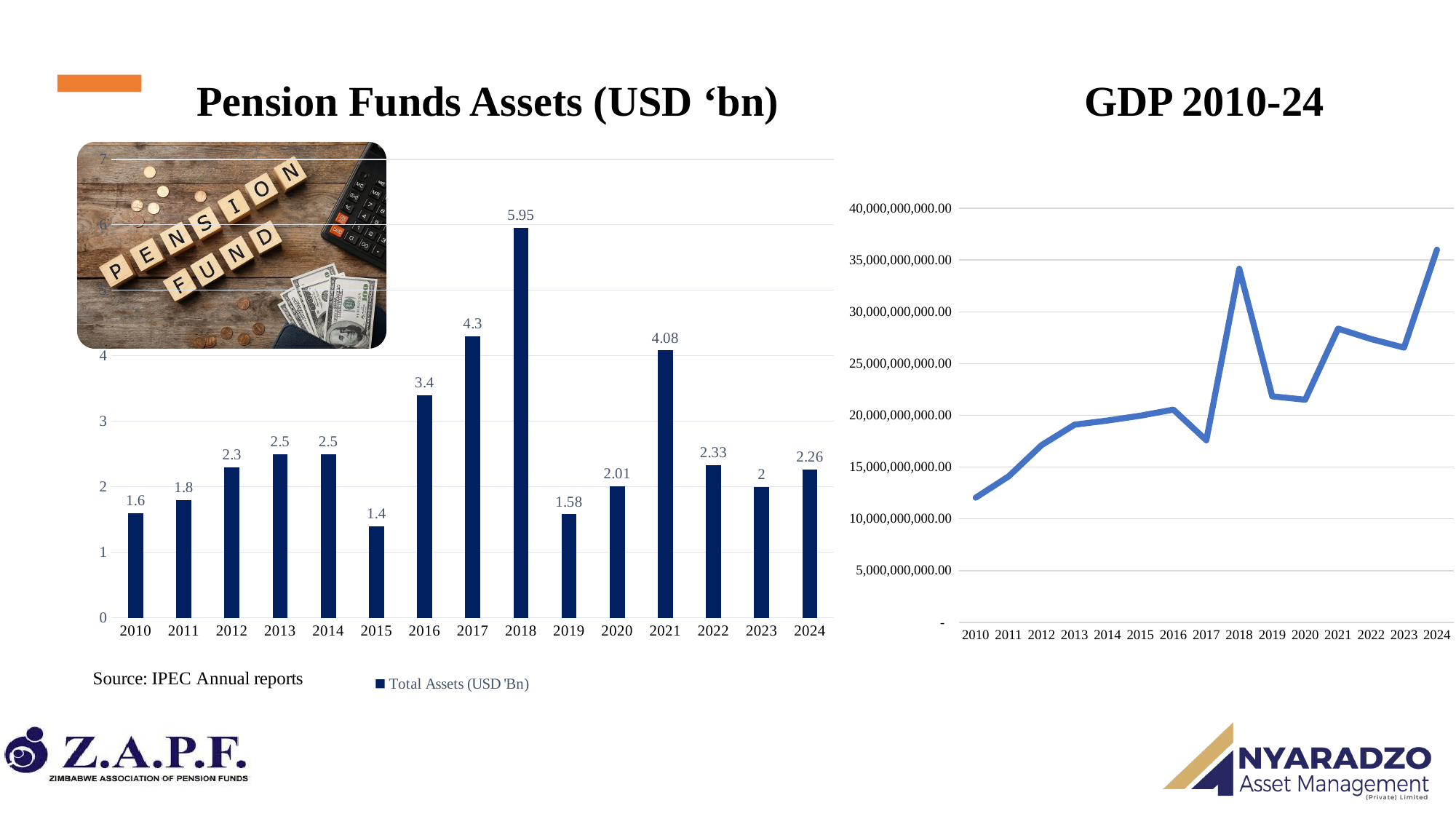
In the GDP 2010-24 chart, is the value for 2018 greater or less than 30,000,000,000.00? greater In the Pension Funds Assets (USD 'bn) chart, which is larger, the value for 2016 or the value for 2022? 2016 What kind of chart is the GDP 2010-24 chart? line chart What kind of chart is the Pension Funds Assets (USD 'bn) chart? bar chart How many years are shown on the x axis of the Pension Funds Assets (USD 'bn) chart? 15 In the Pension Funds Assets (USD 'bn) chart, what is the difference between the values for 2018 and 2017? 1.65 In the Pension Funds Assets (USD 'bn) chart, what is the value for 2021? 4.08 In the GDP 2010-24 chart, is the value for 2010 greater or less than 15,000,000,000.00? less In the Pension Funds Assets (USD 'bn) chart, which year has the lowest value? 2015 In the Pension Funds Assets (USD 'bn) chart, which year has the highest value? 2018 What is the legend entry in the Pension Funds Assets (USD 'bn) chart? Total Assets (USD 'Bn) In the Pension Funds Assets (USD 'bn) chart, what is the value for 2018? 5.95